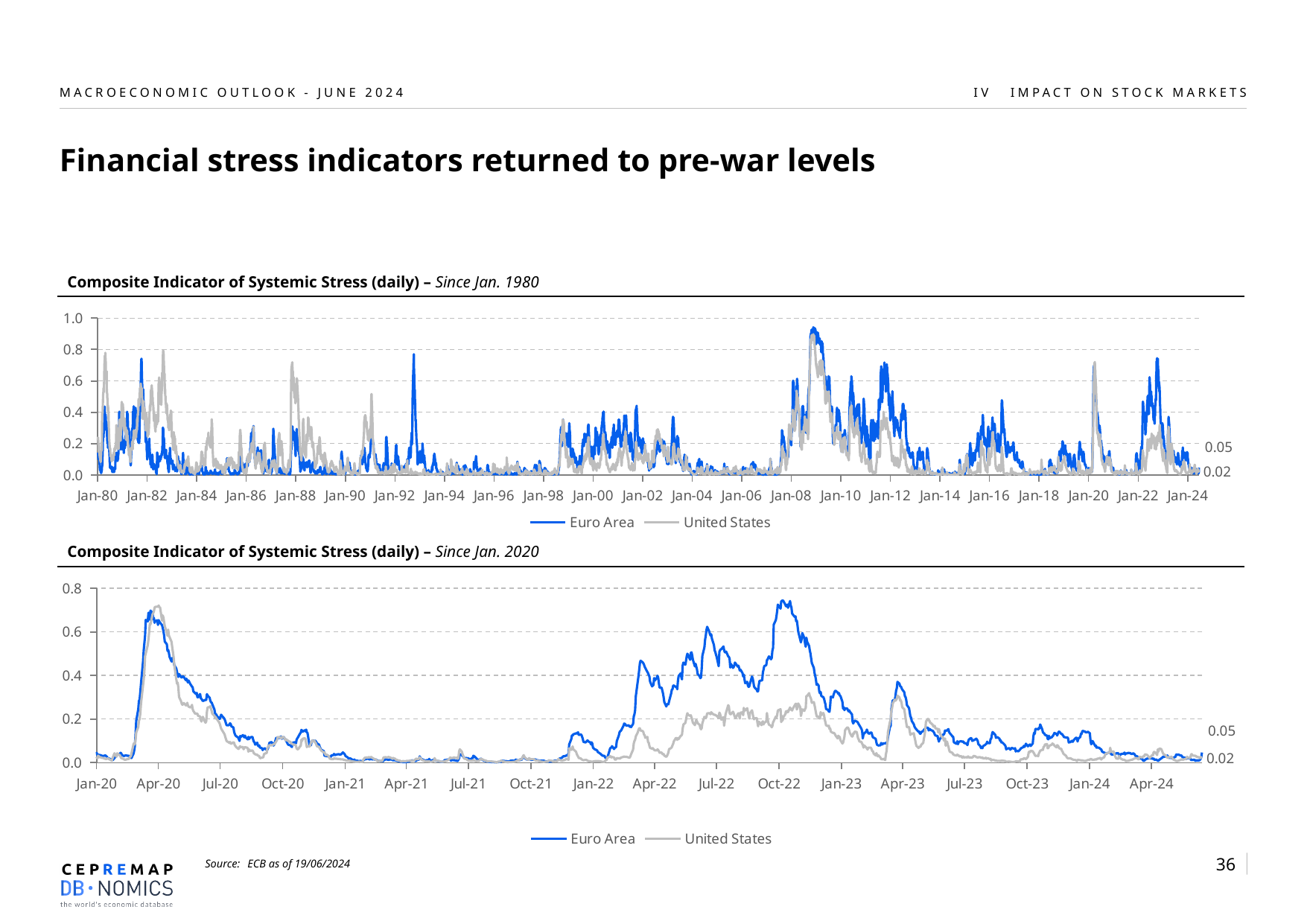
What colour is the Euro Area line in the charts? Blue What kind of chart is the 'Composite Indicator of Systemic Stress (daily) – Since Jan. 1980' chart? Line chart In the 'Since Jan. 2020' chart, does the Euro Area series rise or fall between Oct-22 and Jan-24? fall In the 'Since Jan. 1980' chart, what is the latest labelled value for the United States? 0.02 How many series does the legend of the 'Since Jan. 2020' chart list? 2 In the 'Since Jan. 1980' chart, which series reaches the highest peak around 2008–2009? Euro Area In the 'Since Jan. 2020' chart, is the Euro Area peak around Oct-22 greater or less than 0.6? greater In the 'Since Jan. 2020' chart, is the United States peak around Oct-22 greater or less than 0.4? less In the 'Since Jan. 2020' chart, what is the latest labelled value for the Euro Area? 0.05 In the 'Since Jan. 2020' chart, which series has the higher latest labelled value, Euro Area or United States? Euro Area In the 'Since Jan. 1980' chart, is the Euro Area spike around Jan-92 to Jan-94 greater or less than 0.6? greater In the 'Since Jan. 1980' chart, what is the difference between the latest labelled values of the Euro Area (0.05) and the United States (0.02)? 0.03